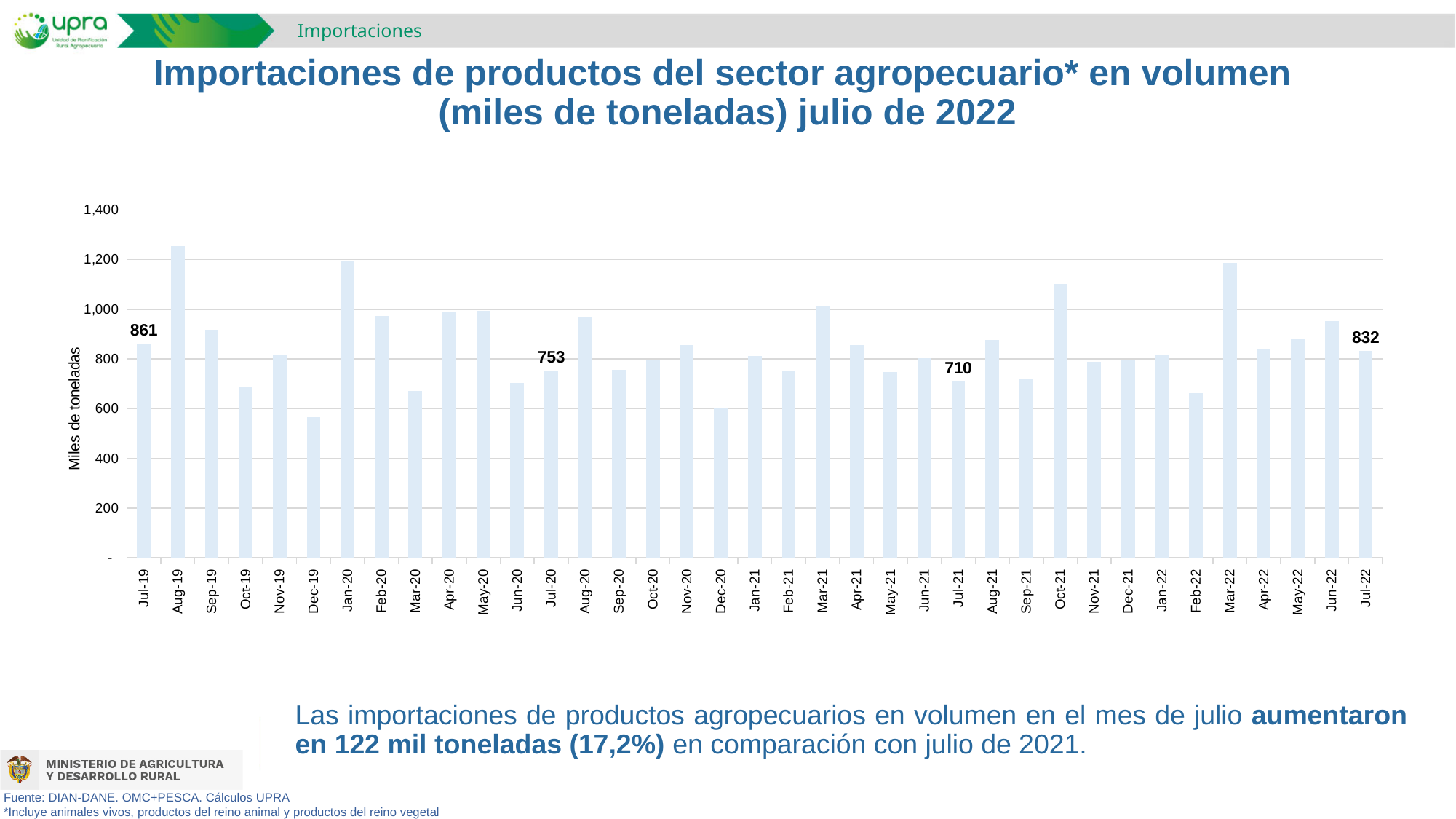
What is the value for Jul-20? 753 Which month has the lowest bar? Dec-19 What kind of chart is shown? bar chart How many months are plotted on the chart? 37 Which is larger, the value for Jul-19 or the value for Jul-22? Jul-19 What is the value for Jul-19? 861 Is the value for Aug-19 greater or less than 1,200? greater Which month has the highest bar? Aug-19 What is the value for Jul-22? 832 What is the difference between the values for Jul-22 and Jul-21? 122 Is the value for Dec-19 greater or less than 600? less What is the value for Jul-21? 710